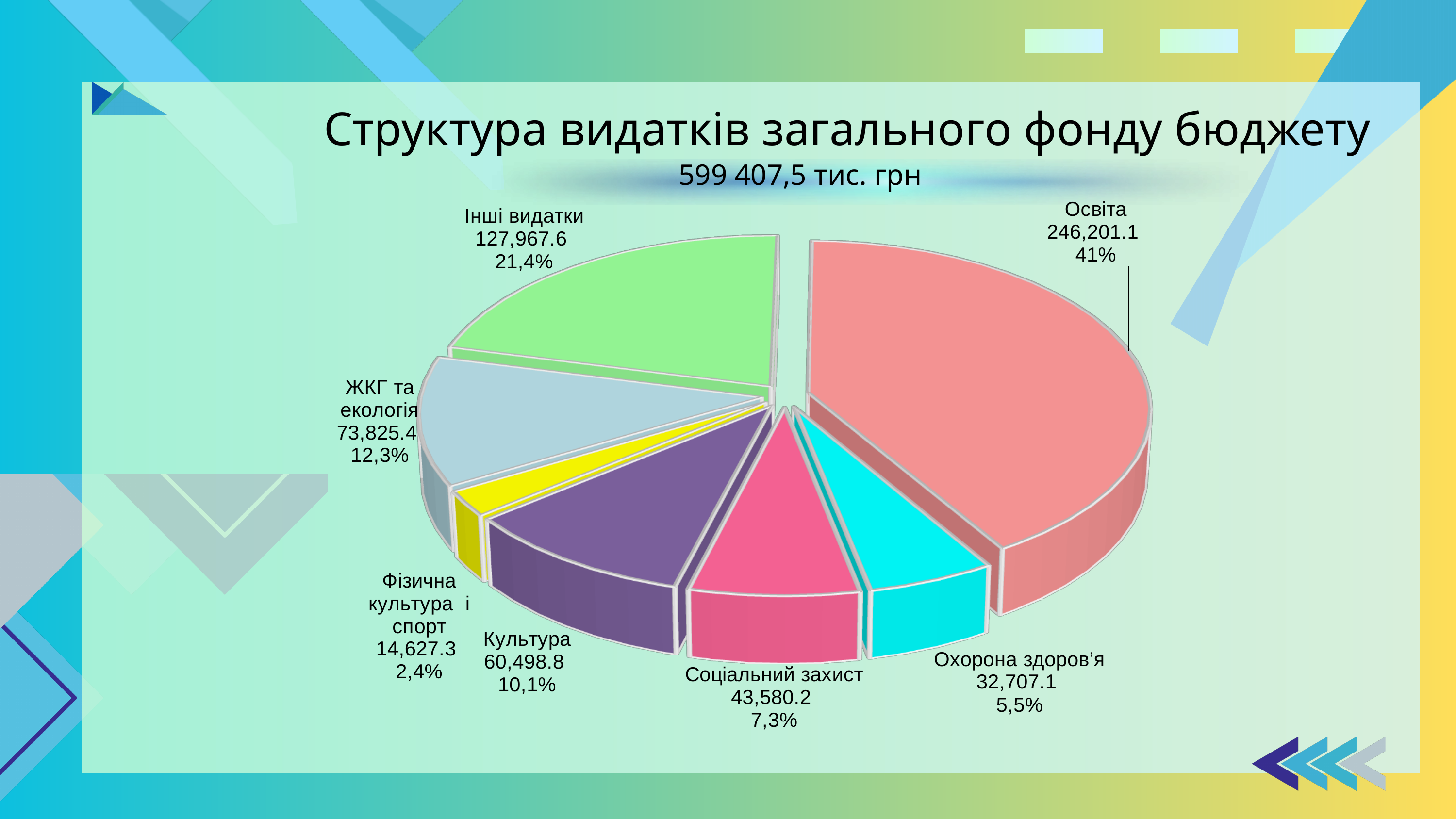
What is the value shown for Освіта? 246,201.1 What percentage share is shown for Охорона здоров'я? 5,5% What is the value shown for Культура? 60,498.8 Which category has the largest slice of the pie? Освіта What is the value shown for Фізична культура і спорт? 14,627.3 How many categories are shown in the pie chart? 7 What type of chart is shown on the slide? pie chart What total amount is shown under the chart title? 599 407,5 тис. грн What percentage share is shown for Інші видатки? 21,4% Which category has the smallest slice of the pie? Фізична культура і спорт What is the difference between the values for Культура and Соціальний захист? 16,918.6 Which is larger, the value for ЖКГ та екологія or the value for Соціальний захист? ЖКГ та екологія